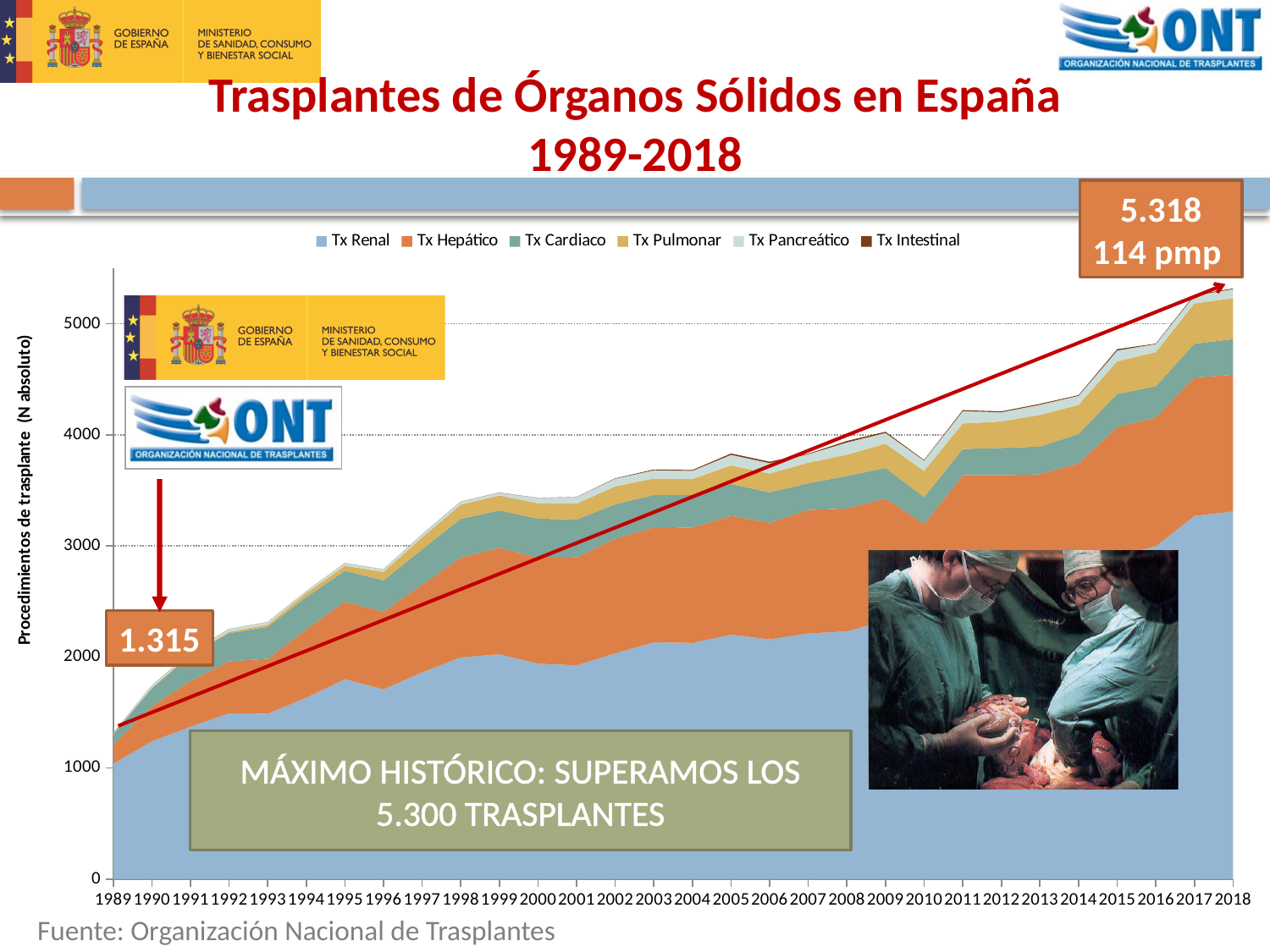
How many series does the legend list? 6 What is the total number of solid organ transplants shown for 1989? 1.315 Which series forms the bottom (largest) layer of the stacked area chart? Tx Renal Which year has the highest total number of transplants? 2018 What is the total number of solid organ transplants shown for 2018? 5.318 How many years are plotted along the x axis? 30 Is the total number of transplants in 2010 greater or less than 4000? less What kind of chart is shown on the slide? stacked area chart Which year has the lowest total number of transplants? 1989 By how much did the total number of transplants increase from 1989 to 2018? 4.003 Do the total transplants generally rise or fall from 1989 to 2018? rise What is the rate per million population (pmp) shown for 2018? 114 pmp